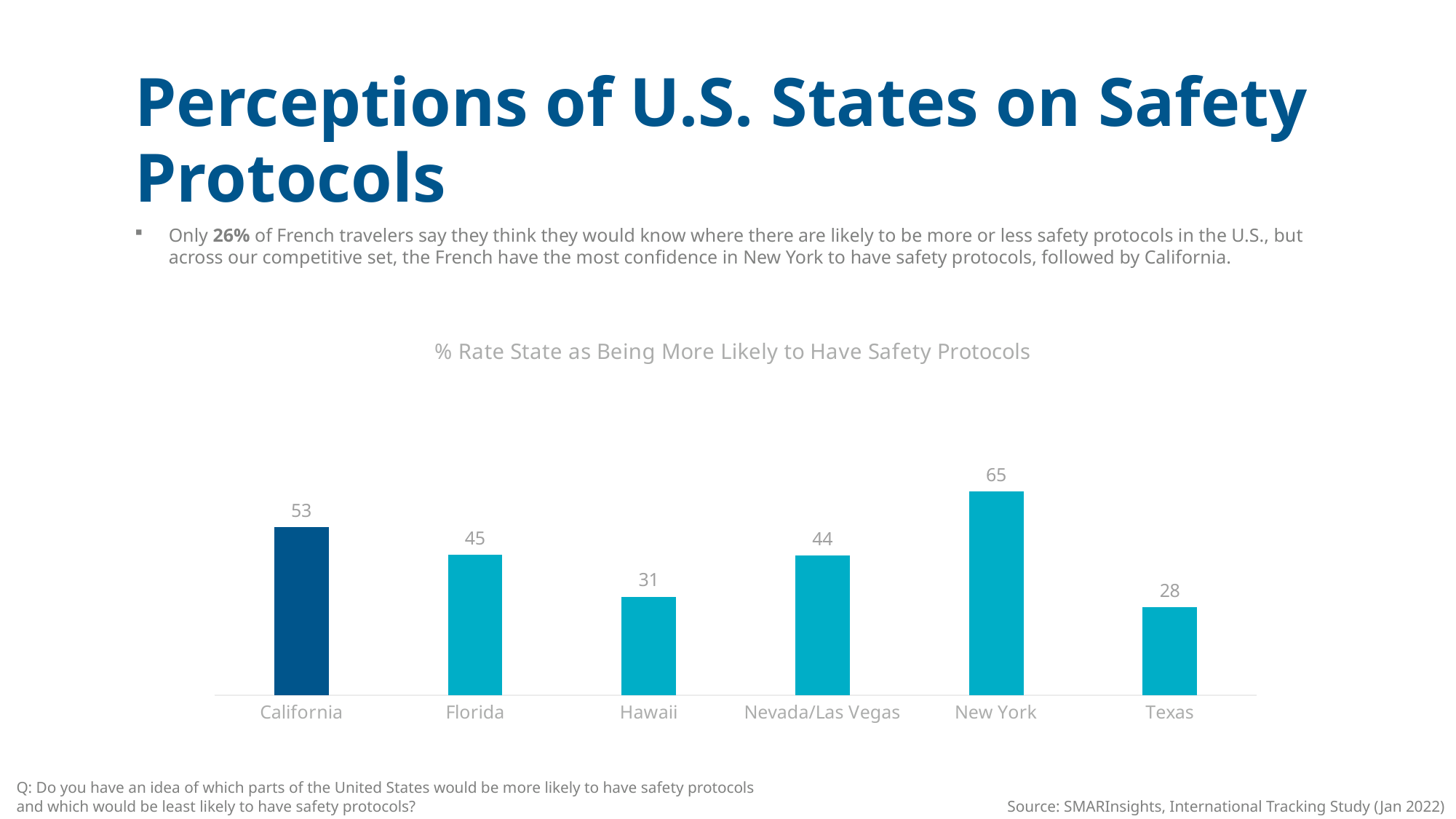
What is the difference between the values for Florida and Texas? 17 What is the value for Hawaii? 31 What is the title of the chart? % Rate State as Being More Likely to Have Safety Protocols Which has a larger value, Hawaii or Texas? Hawaii What kind of chart is shown on the slide? Bar chart Which has a larger value, California or Florida? California What is the difference between the values for New York and California? 12 Which state has the highest value? New York What is the value for Nevada/Las Vegas? 44 Which state has the lowest value? Texas How many states are shown in the chart? 6 What is the value for New York? 65